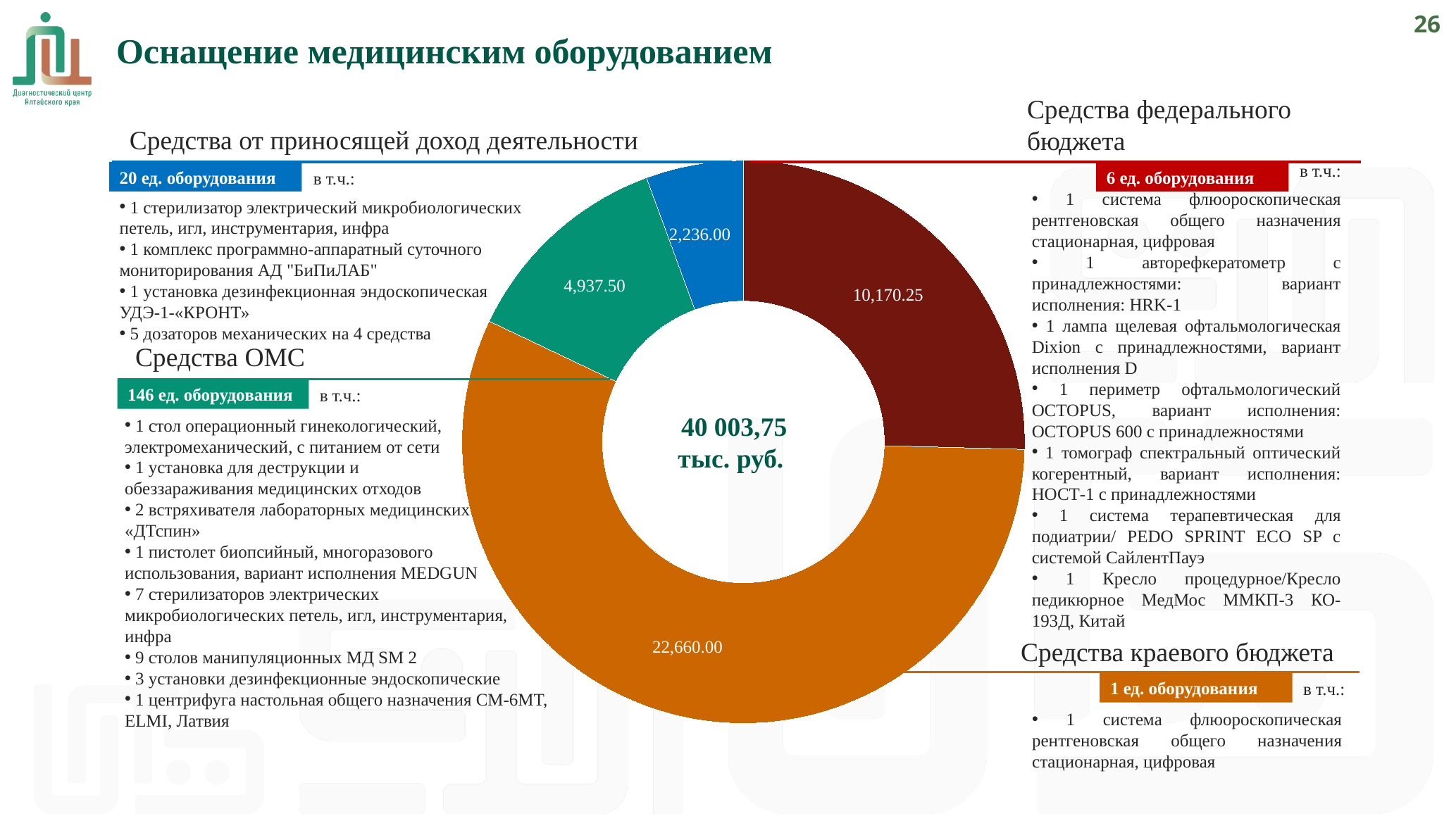
What is the value of the green slice (Средства ОМС)? 4,937.50 How many slices does the donut chart have? 4 Which funding source has the smallest slice in the donut chart? Средства от приносящей доход деятельности (2,236.00) What type of chart is shown on the slide? Donut (pie) chart Which is larger: the green slice (Средства ОМС) or the blue slice (Средства от приносящей доход деятельности)? Green slice (Средства ОМС), 4,937.50 What is the value of the largest slice (orange, Средства краевого бюджета)? 22,660.00 What total value is shown in the centre of the donut chart? 40 003,75 тыс. руб. What is the value of the dark red slice (Средства федерального бюджета)? 10,170.25 What is the difference between the orange slice (22,660.00) and the dark red slice (10,170.25)? 12,489.75 What is the value of the blue slice (Средства от приносящей доход деятельности)? 2,236.00 Which funding source has the largest slice in the donut chart? Средства краевого бюджета (22,660.00) How many units of equipment are listed for Средства ОМС? 146 ед. оборудования